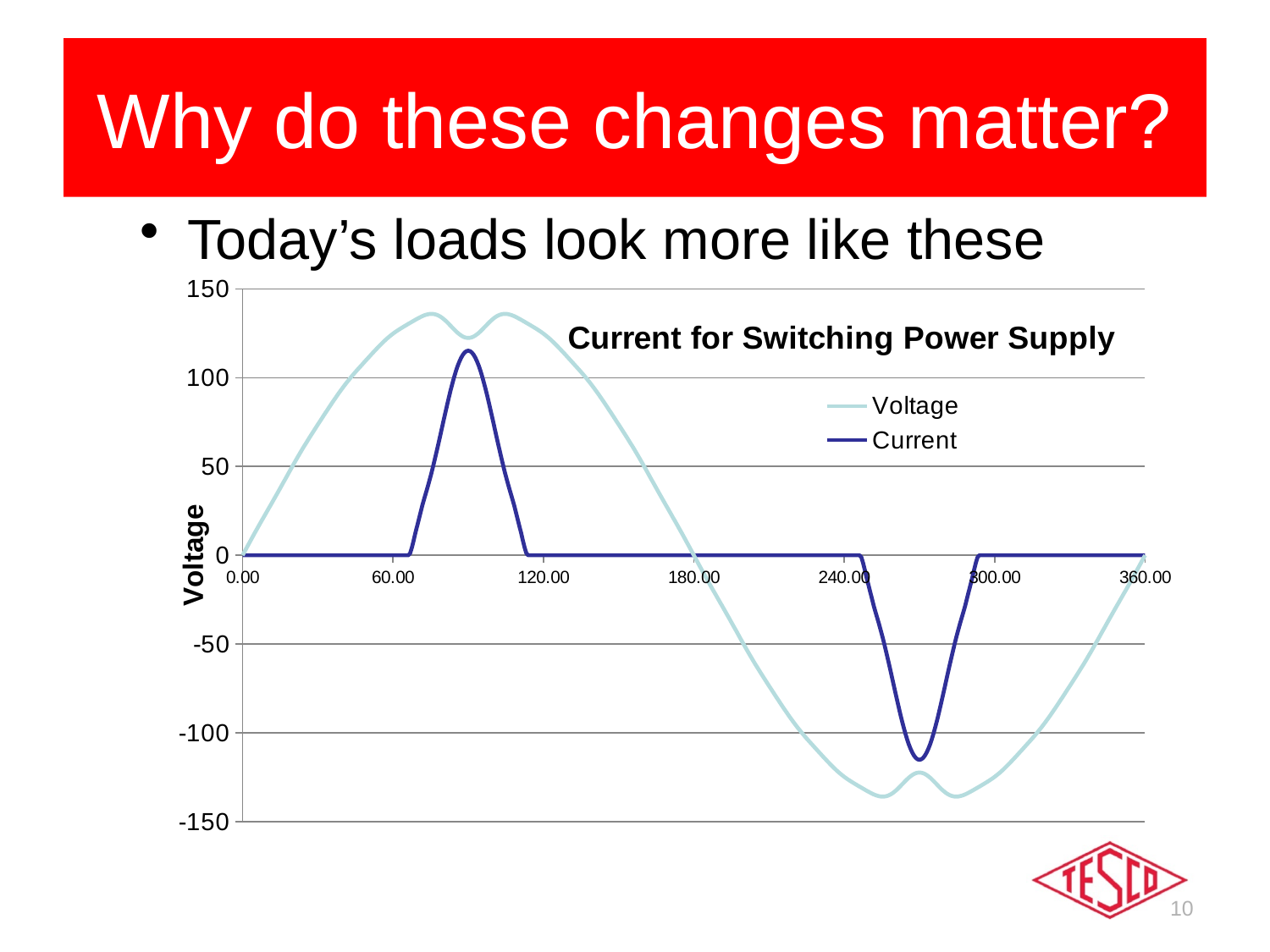
Is the peak value of the Current series greater or less than 150? less What are the two series named in the chart legend? Voltage and Current Which series reaches a higher maximum value, Voltage or Current? Voltage Is the peak value of the Voltage series greater or less than 100? greater What is the Current value at x = 0.00? 0 Is the Voltage value at x = 240.00 greater or less than -100? less What is the Voltage value at x = 180.00? 0 What kind of chart is shown on the slide? line chart What is the title of the chart? Current for Switching Power Supply How many tick labels are shown on the x axis? 7 How many series does the chart legend list? 2